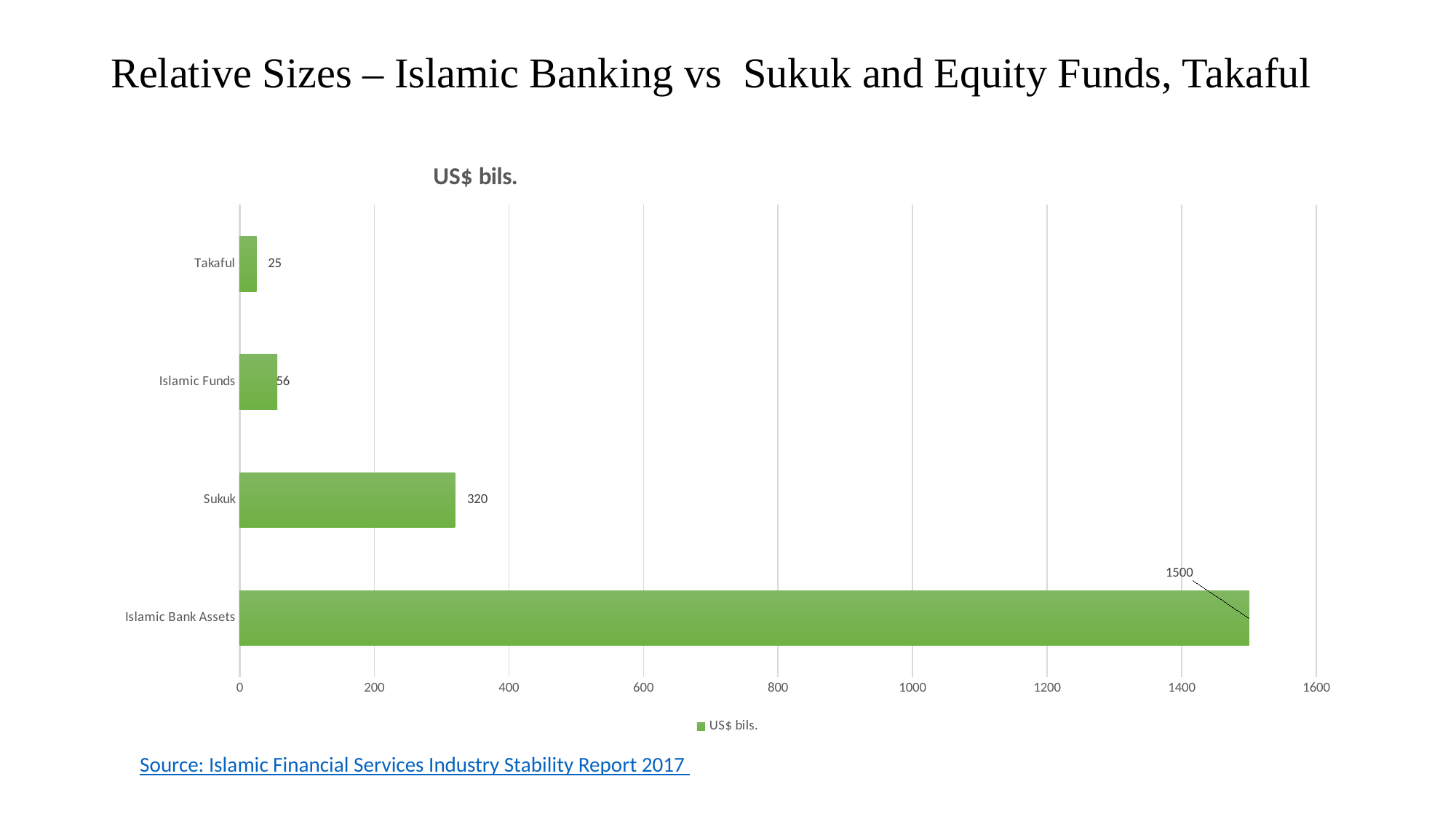
What is the value for Takaful? 25 What is the value for Islamic Funds? 56 What is the difference between the values for Islamic Funds and Takaful? 31 What is the title of the chart? US$ bils. What is the value for Islamic Bank Assets? 1500 Which is larger, the value for Sukuk or the value for Islamic Funds? Sukuk How many categories are shown in the chart? 4 What is the difference between the values for Islamic Bank Assets and Sukuk? 1180 What is the value for Sukuk? 320 Which category has the lowest value? Takaful Which category has the highest value? Islamic Bank Assets What kind of chart is shown on the slide? Bar chart